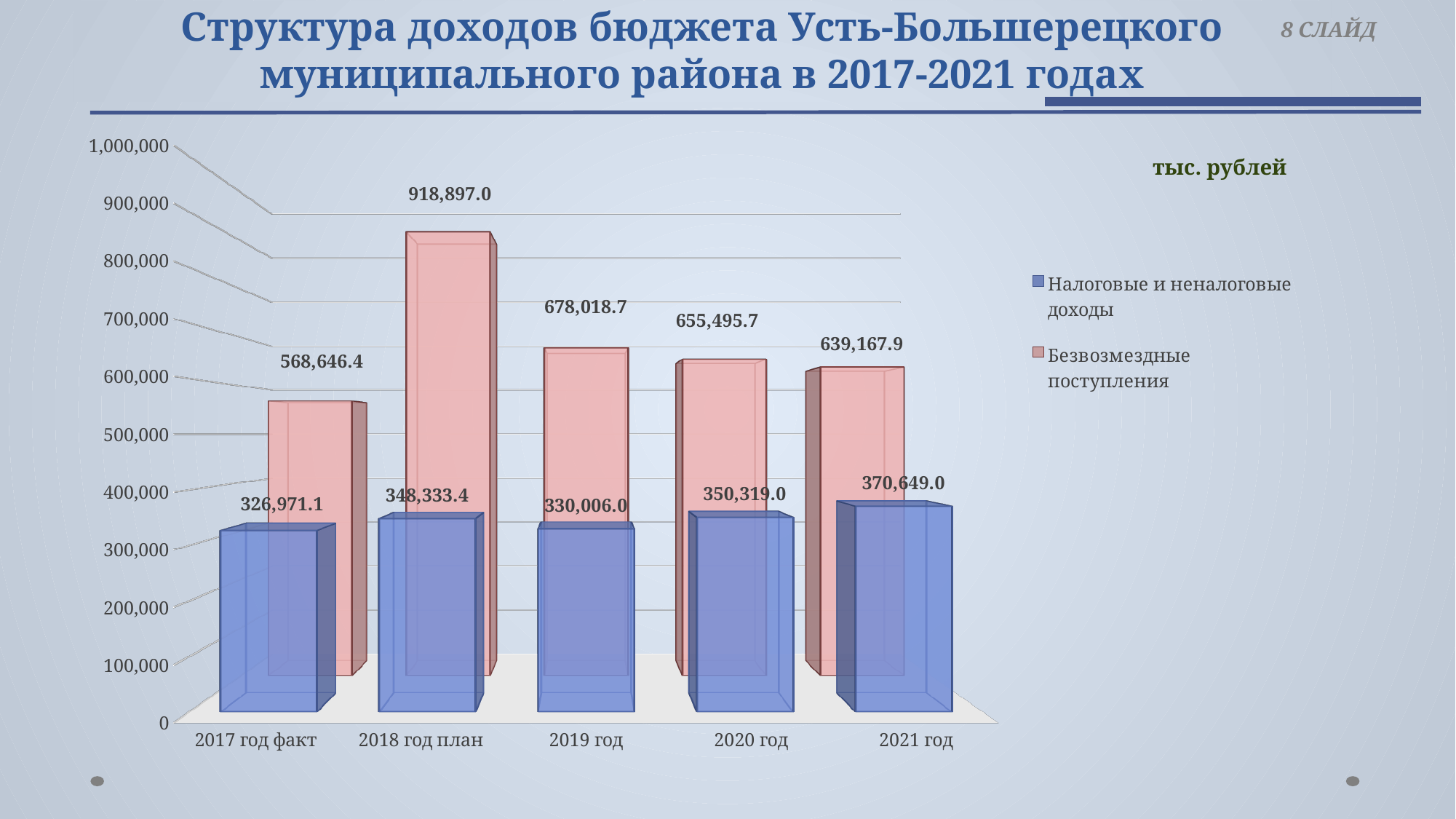
Which is larger in 2020 год: Налоговые и неналоговые доходы or Безвозмездные поступления? Безвозмездные поступления What is the difference between Безвозмездные поступления and Налоговые и неналоговые доходы in 2018 год план? 570,563.6 Do the values of Безвозмездные поступления rise or fall from 2018 год план to 2021 год? Fall How many series does the legend list? 2 What is the value of Налоговые и неналоговые доходы for 2017 год факт? 326,971.1 How many year categories are shown on the x axis? 5 What kind of chart is shown on the slide? Bar chart In which year is Налоговые и неналоговые доходы highest? 2021 год In which year is Налоговые и неналоговые доходы lowest? 2017 год факт In which year is Безвозмездные поступления highest? 2018 год план What is the value of Безвозмездные поступления for 2021 год? 639,167.9 What is the value of Безвозмездные поступления for 2018 год план? 918,897.0